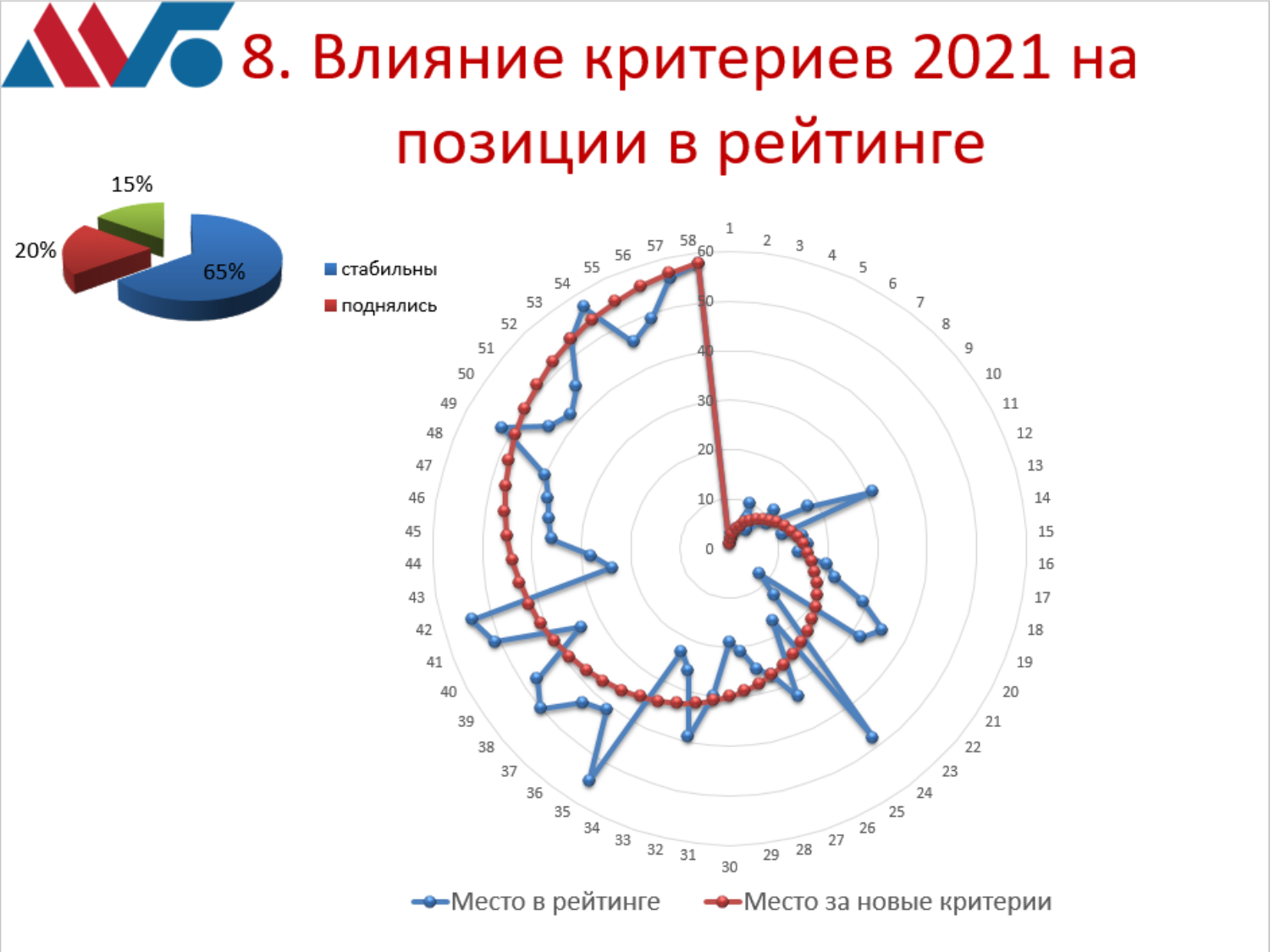
What kind of chart is the large chart on the right of the slide? Radar chart On the radar chart, how many series does the legend list? 2 On the pie chart at the top left, what is the difference in percentage points between the 65% slice and the 20% slice? 45 What kind of chart is the chart at the top left of the slide? Pie chart On the pie chart at the top left, what share is shown for "поднялись"? 20% On the pie chart at the top left, what is the value of the smallest slice? 15% On the pie chart at the top left, what is the value of the largest slice? 65% On the radar chart, how many categories are there around the outside? 58 On the pie chart at the top left, what share is shown for "стабильны"? 65% On the pie chart at the top left, how many slices are there? 3